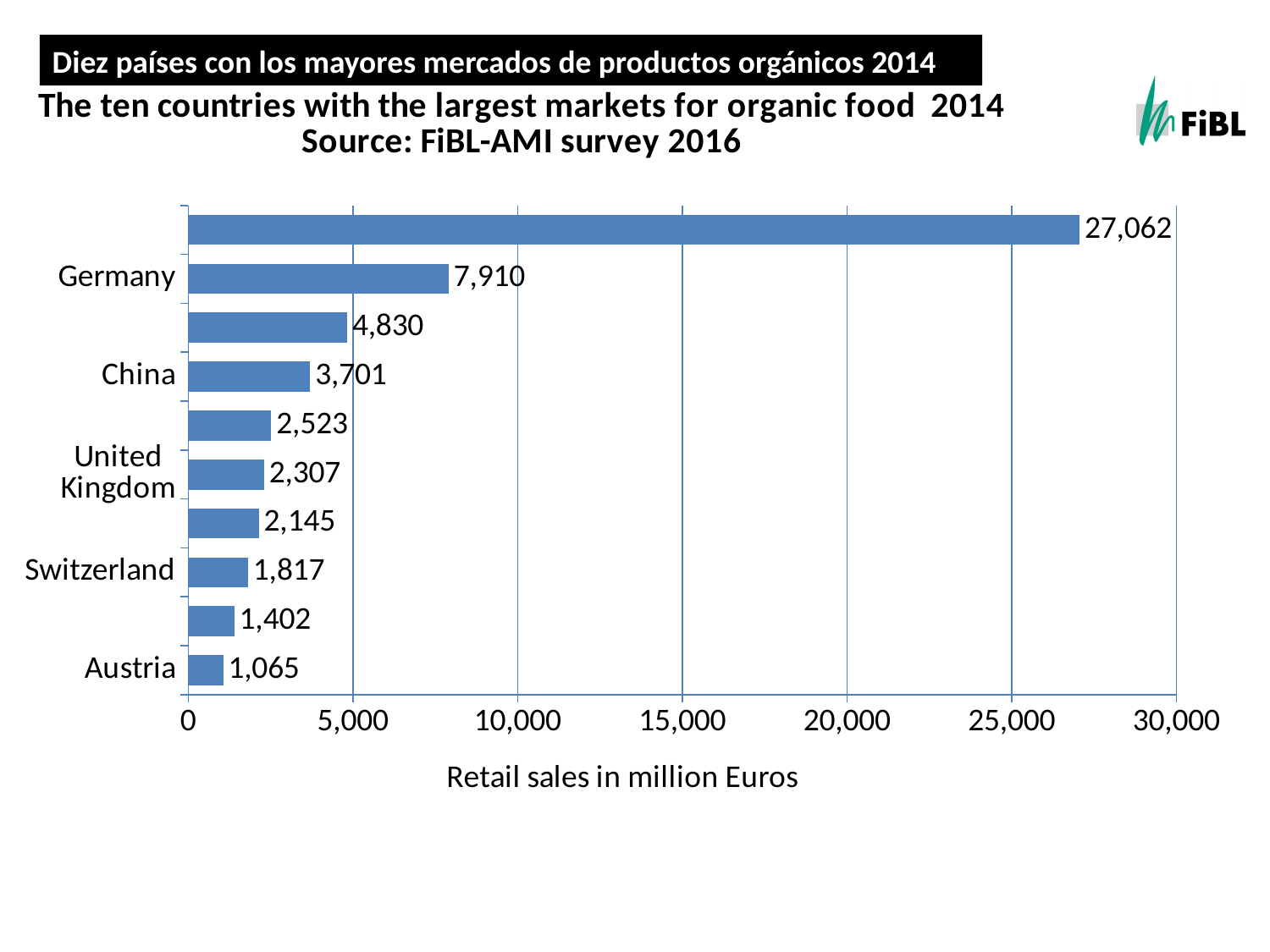
Which has higher retail sales, Germany or China? Germany Is the value for Germany greater or less than 5,000? greater Which labelled country has the lowest retail sales in the chart? Austria What kind of chart is shown on the slide? Bar chart How many bars are shown in the chart? 10 What is the retail sales value for China? 3,701 What is the retail sales value for the United Kingdom? 2,307 What is the difference in retail sales between Germany and China? 4,209 What is the retail sales value for Switzerland? 1,817 What is the value shown on the longest bar in the chart? 27,062 What is the retail sales value for Germany? 7,910 What is the retail sales value for Austria? 1,065